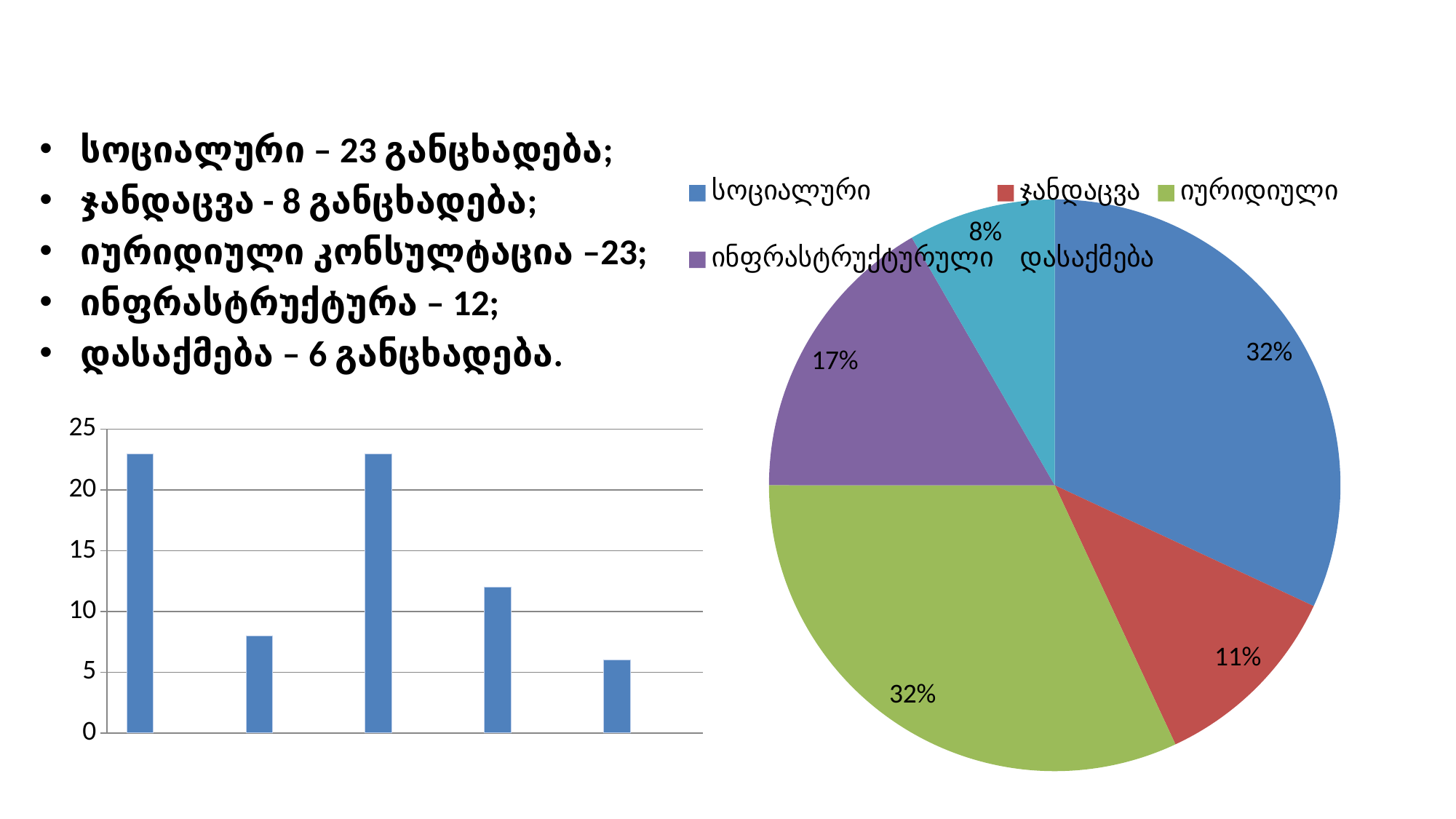
In the bar chart at the bottom left, is the value of the fourth bar from the left greater or less than 10? greater In the pie chart on the right, which slice is larger: ჯანდაცვა or ინფრასტრუქტურული? ინფრასტრუქტურული How many bars are there in the bar chart at the bottom left of the slide? 5 In the pie chart on the right, what share of the pie does the სოციალური slice have? 32% What kind of chart is the chart at the bottom left of the slide? bar chart In the pie chart on the right, what share of the pie does the ინფრასტრუქტურული slice have? 17% In the pie chart on the right, what share of the pie does the დასაქმება slice have? 8% In the pie chart on the right, which slice is the smallest? დასაქმება In the pie chart on the right, how many percentage points larger is the ინფრასტრუქტურული slice than the დასაქმება slice? 9 What kind of chart is the chart on the right side of the slide? pie chart How many entries does the legend of the pie chart on the right list? 5